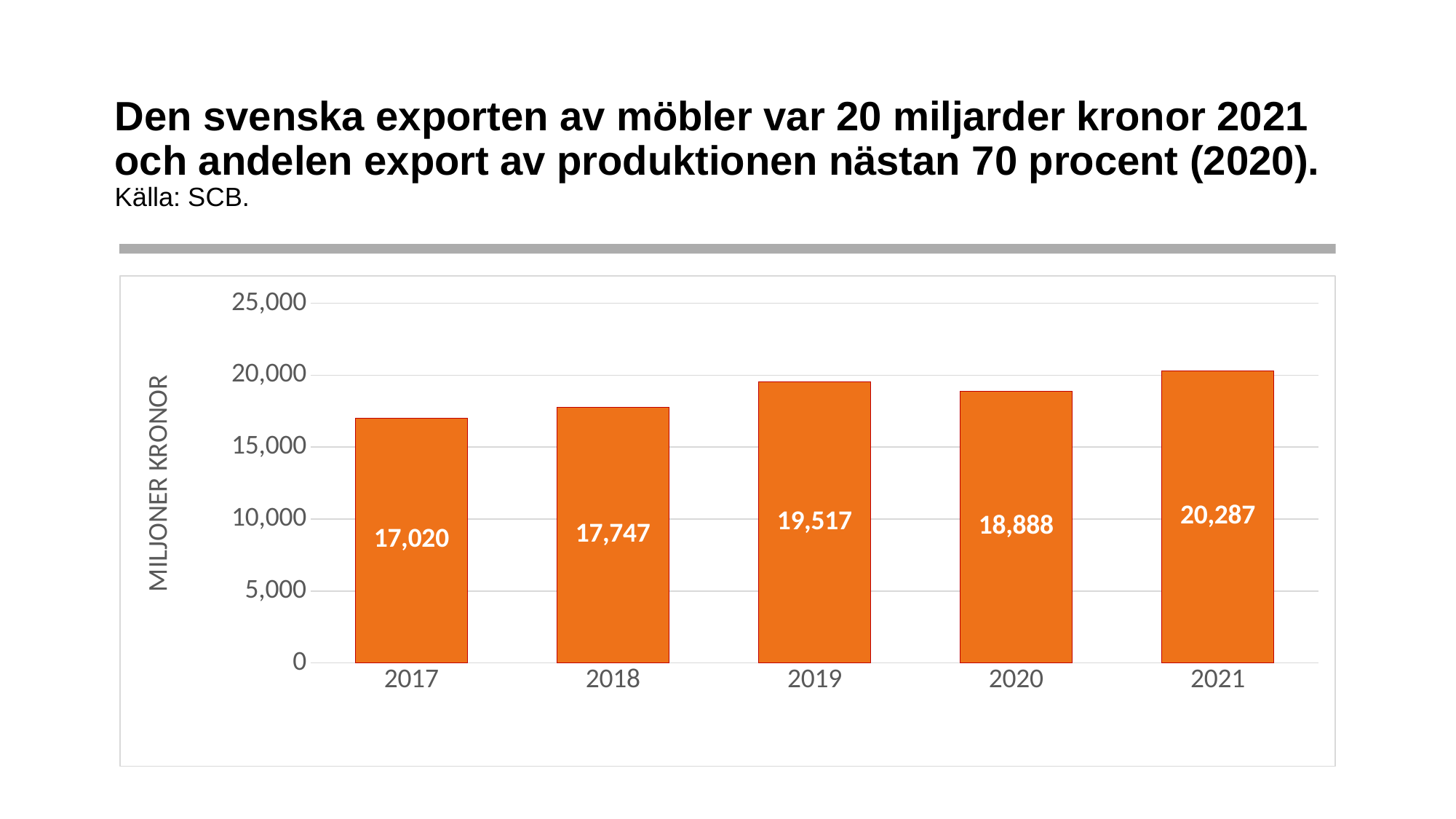
Is the value for 2018 greater or less than 20,000? less What kind of chart is shown on the slide? bar chart What is the difference between the values for 2019 and 2020? 629 What is the value for 2021? 20,287 Which is larger, the value for 2019 or the value for 2020? 2019 Which year has the lowest value? 2017 What is the label on the vertical axis? MILJONER KRONOR Which year has the highest value? 2021 What is the value for 2019? 19,517 What is the difference between the values for 2021 and 2017? 3,267 What is the value for 2017? 17,020 How many years are shown on the x axis? 5